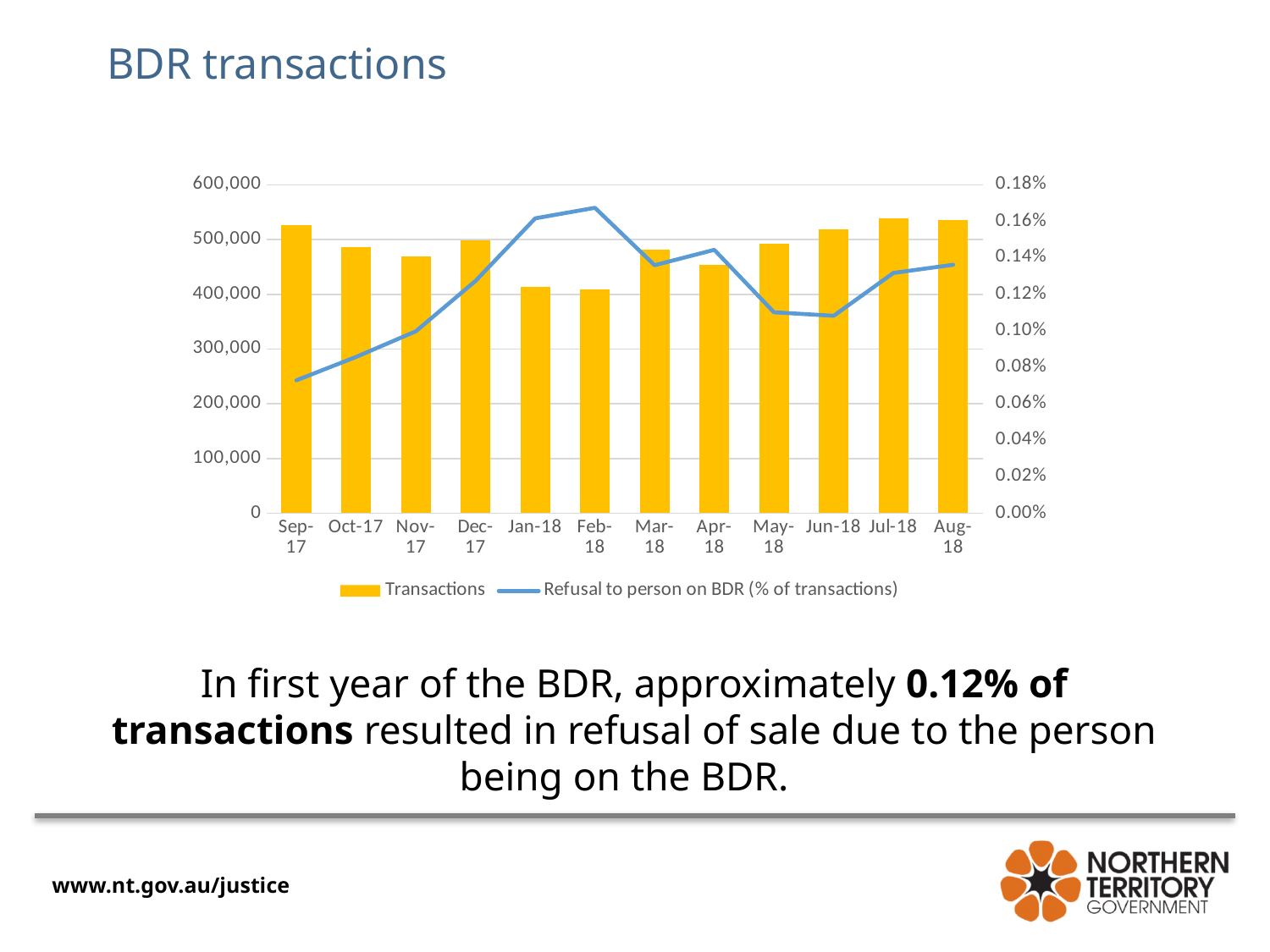
Is the number of transactions for Feb-18 greater or less than 500,000? less How many months are shown on the x axis of the chart? 12 Which month has more transactions, Sep-17 or Feb-18? Sep-17 Is the number of transactions for Sep-17 greater or less than 500,000? greater In which month is the refusal to person on BDR percentage lowest? Sep-17 How many series does the chart legend list? 2 What kind of chart is shown on the slide? Combination bar and line chart Is the refusal to person on BDR percentage for Sep-17 greater or less than 0.10%? less In which month is the refusal to person on BDR percentage highest? Feb-18 Does the refusal to person on BDR percentage rise or fall from Sep-17 to Feb-18? rise Which series is plotted as a line in the chart? Refusal to person on BDR (% of transactions) What is the title of the chart? BDR transactions